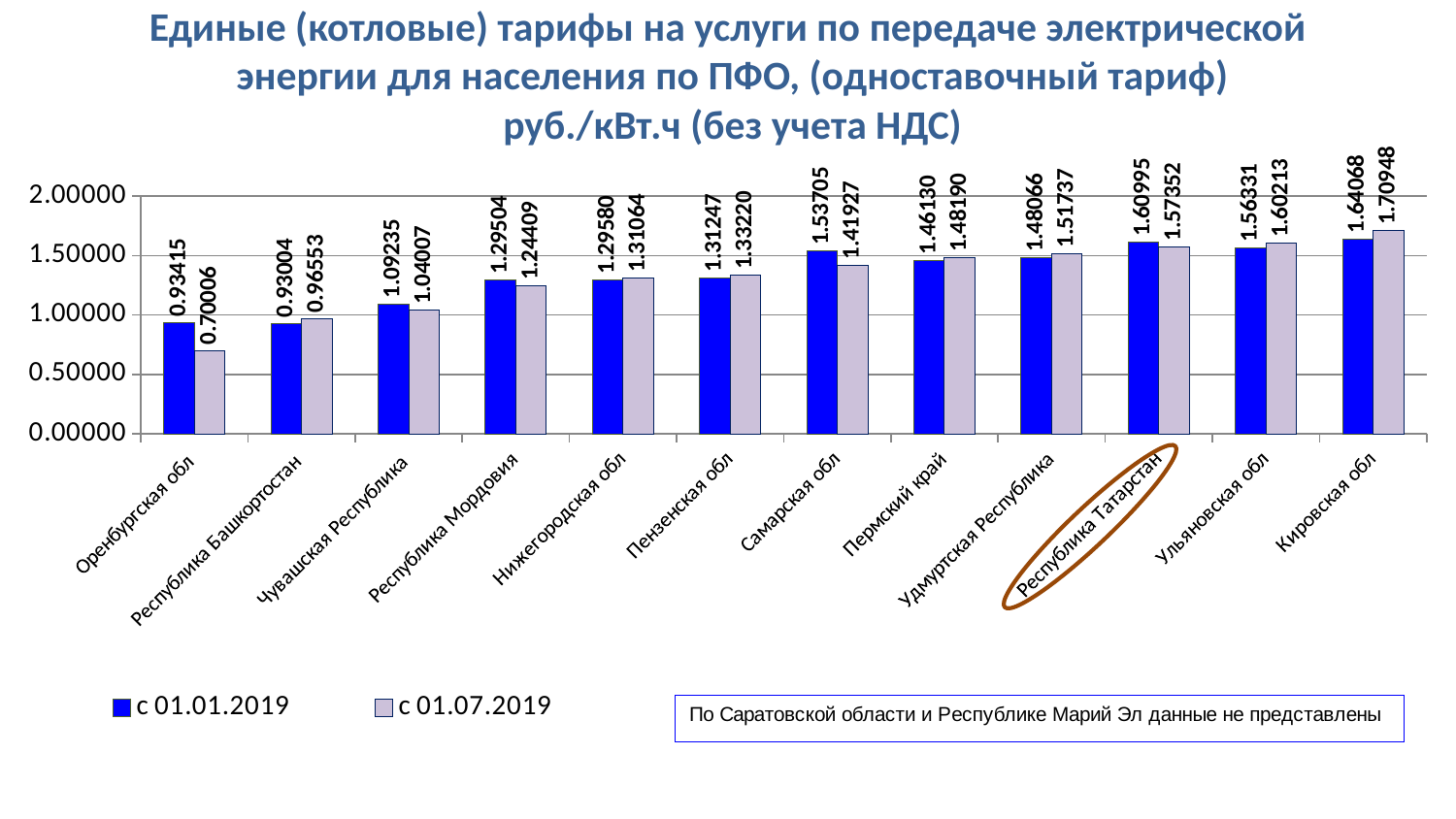
Which category has the highest value in the series с 01.07.2019? Кировская обл Which is larger for Самарская обл: the value for с 01.01.2019 or с 01.07.2019? с 01.01.2019 What is the difference between the с 01.07.2019 and с 01.01.2019 values for Кировская обл? 0.06880 Which category has the lowest value in the series с 01.07.2019? Оренбургская обл Which category has the highest value in the series с 01.01.2019? Кировская обл What is the value for Самарская обл in the series с 01.01.2019? 1.53705 How many series does the legend list? 2 What is the value for Республика Татарстан in the series с 01.01.2019? 1.60995 Is the value for Оренбургская обл in the series с 01.07.2019 greater or less than 1.00000? less What is the value for Оренбургская обл in the series с 01.07.2019? 0.70006 How many categories (regions) are shown on the x axis? 12 What kind of chart is shown on the slide? bar chart